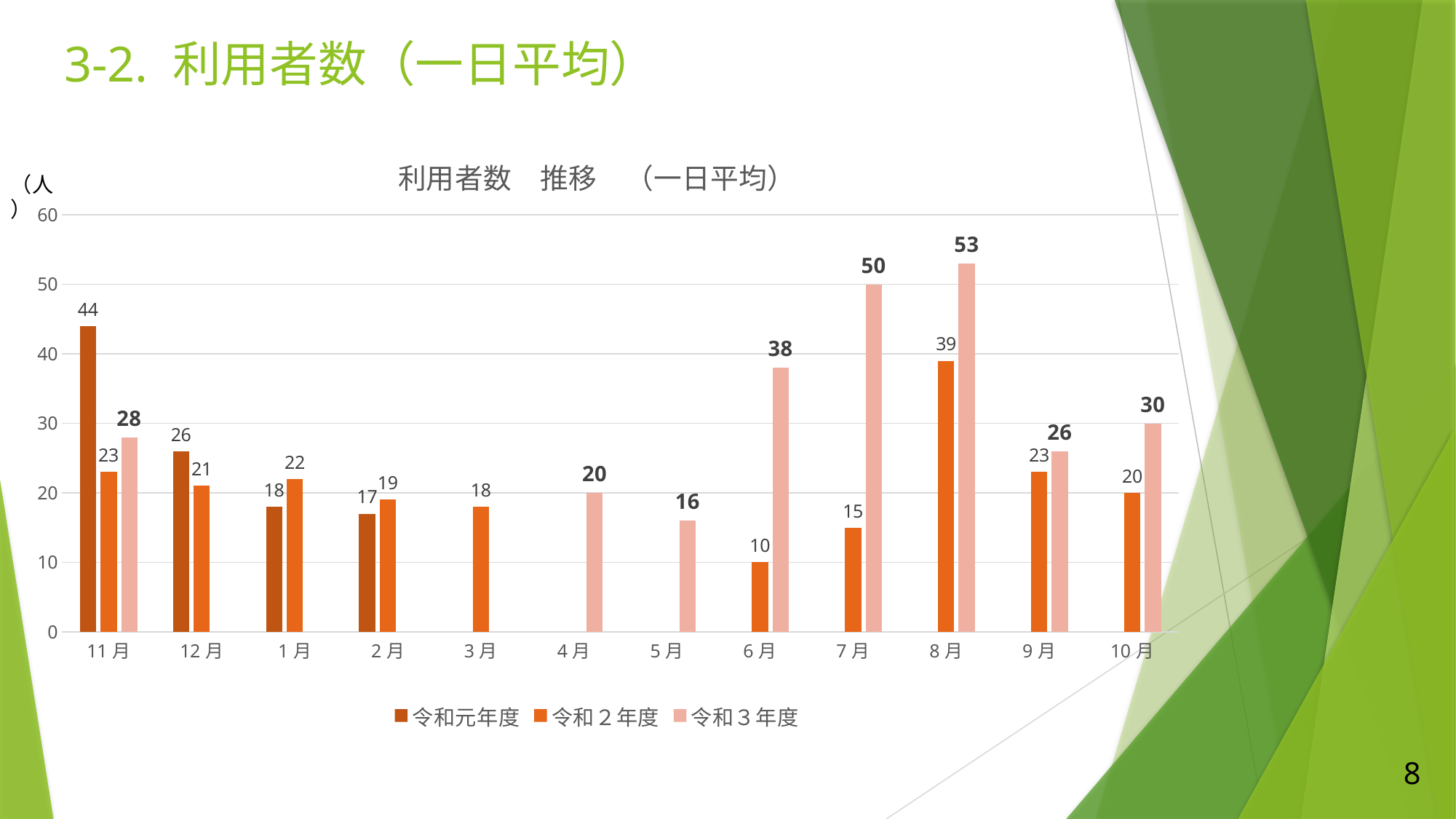
What is the value for 令和元年度 in 11月? 44 How many series does the legend list? 3 What is the difference between the 令和３年度 and 令和２年度 values in 7月? 35 What kind of chart is shown on the slide? bar chart What is the value for 令和３年度 in 8月? 53 What is the value for 令和２年度 in 6月? 10 How many months are shown on the x axis? 12 What is the title of the chart? 利用者数 推移 （一日平均） Is the value for 令和３年度 in 6月 greater or less than 30? greater Which is larger in 1月: the 令和元年度 value or the 令和２年度 value? 令和２年度 Which month has the lowest value for the 令和２年度 series? 6月 Which month has the highest value for the 令和３年度 series? 8月